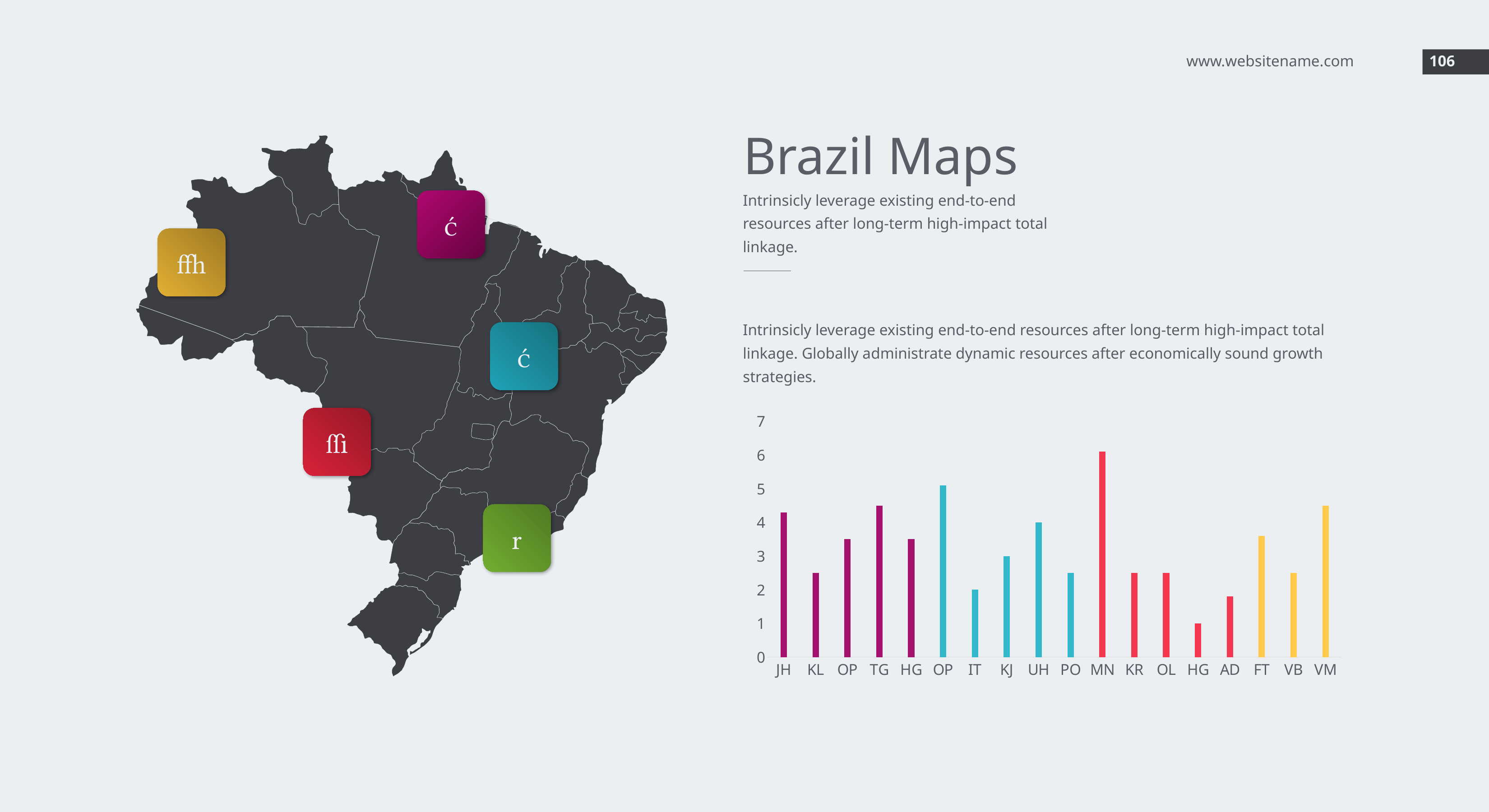
What is the highest value shown on the chart's vertical axis? 7 Which category has the highest bar in the chart? MN Which is larger, the value for JH or the value for IT? JH How many bars are plotted in the chart? 18 Is the value for AD greater or less than 3? less What kind of chart is shown on the slide? bar chart Is the value for VM greater or less than 4? greater Is the value for IT greater or less than 3? less Which is larger, the value for MN or the value for KL? MN